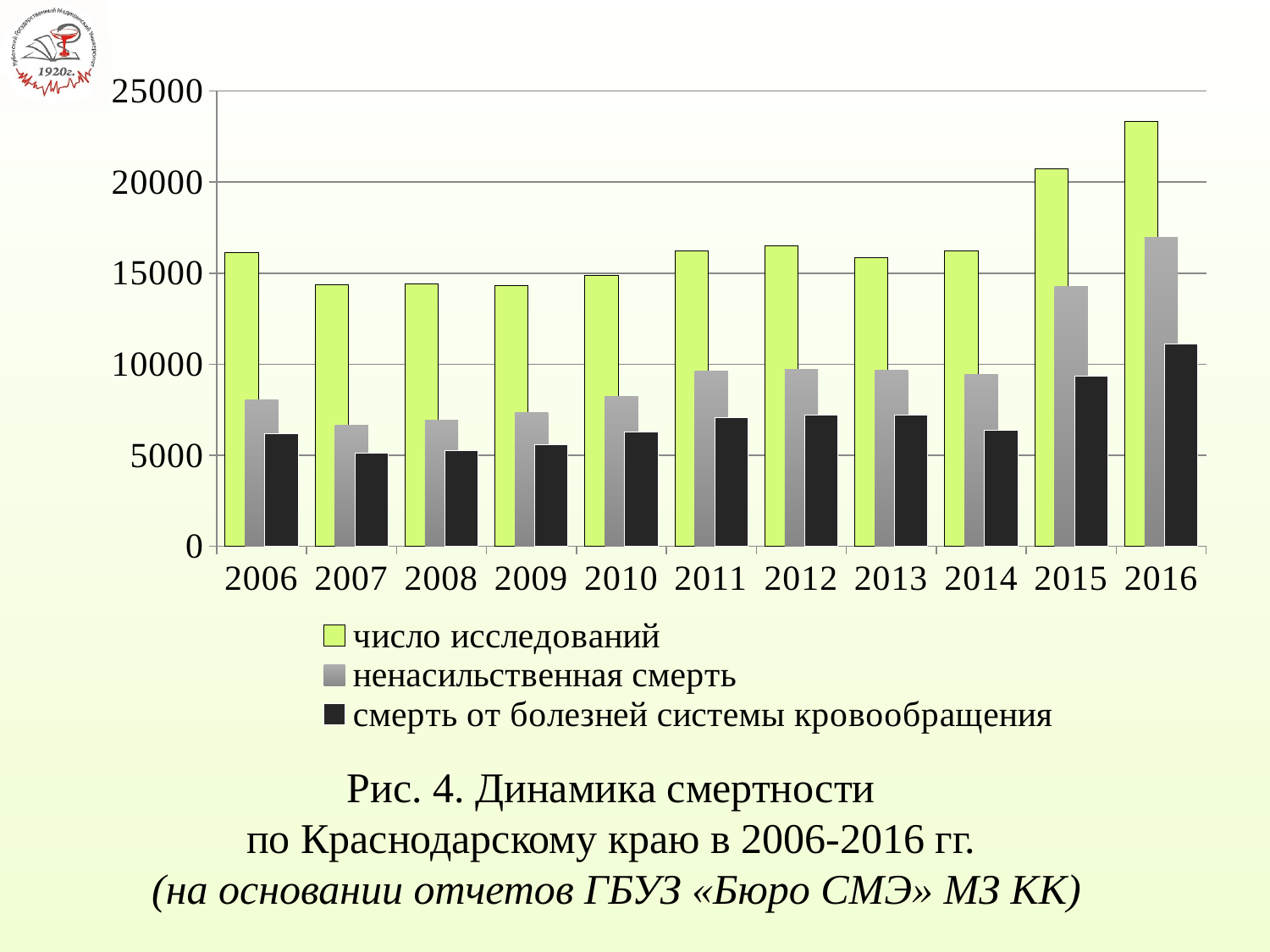
Does the value for число исследований rise or fall from 2014 to 2016? rise In which year is the value for смерть от болезней системы кровообращения highest? 2016 In which year is the value for ненасильственная смерть highest? 2016 How many years are shown on the x axis? 11 Which is larger: ненасильственная смерть in 2015 or in 2014? 2015 Is the value for число исследований in 2007 greater or less than 15000? less In which year is the value for число исследований highest? 2016 What kind of chart is shown on the slide? bar chart How many series does the legend list? 3 Is the value for число исследований in 2016 greater or less than 20000? greater Is the value for смерть от болезней системы кровообращения in 2016 greater or less than 10000? greater